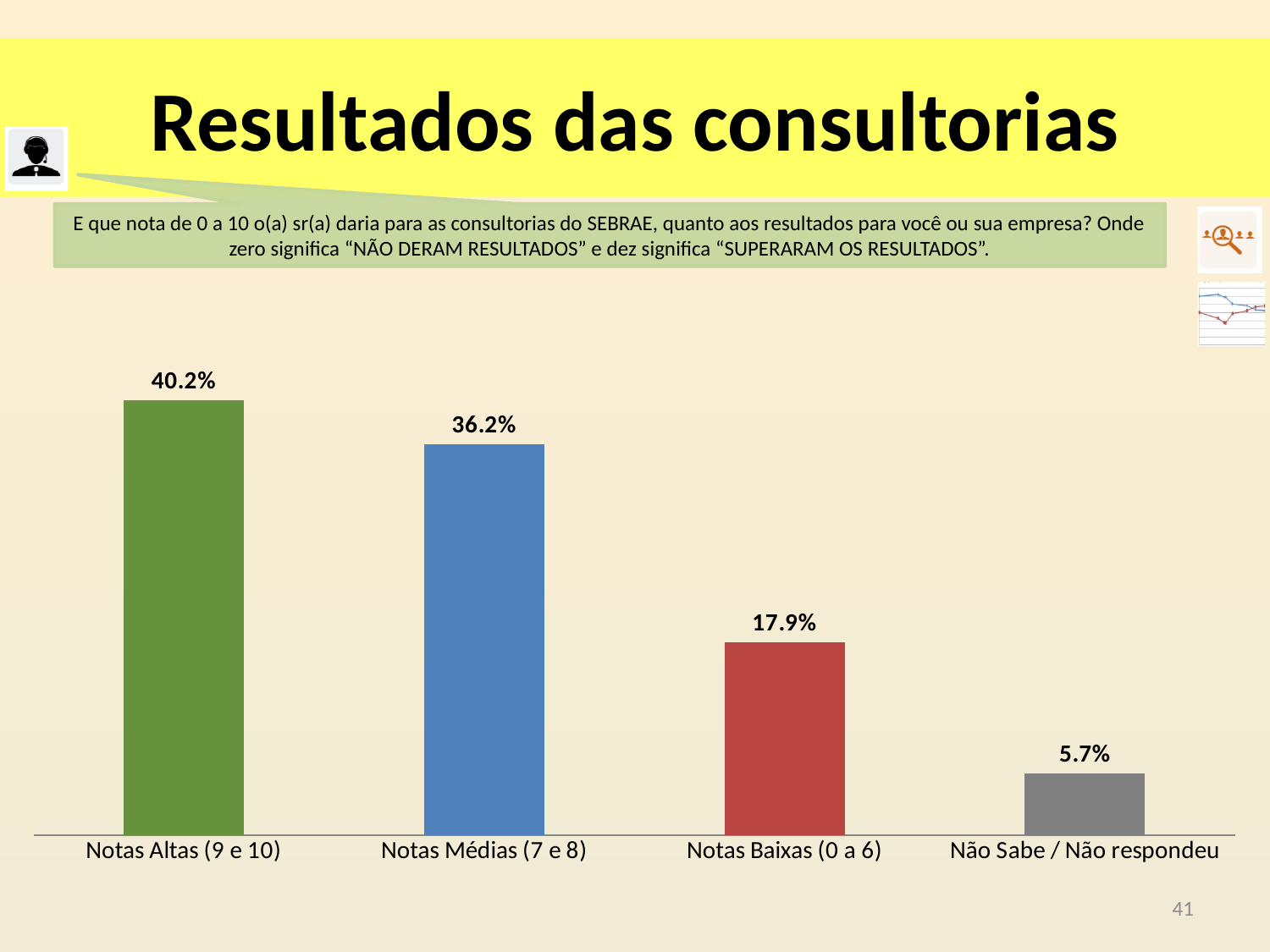
Which category has the highest value? Notas Altas (9 e 10) What is the value for Notas Baixas (0 a 6)? 17.9% What is the value for Não Sabe / Não respondeu? 5.7% Which is larger, the value for Notas Médias (7 e 8) or the value for Notas Baixas (0 a 6)? Notas Médias (7 e 8) What kind of chart is shown on the slide? Bar chart Which category has the lowest value? Não Sabe / Não respondeu What is the value for Notas Médias (7 e 8)? 36.2% How many categories are shown in the chart? 4 Do the values rise or fall from left to right across the categories? Fall What is the difference between the values for Notas Altas (9 e 10) and Notas Médias (7 e 8)? 4.0% What is the value for Notas Altas (9 e 10)? 40.2% What is the difference between the values for Notas Baixas (0 a 6) and Não Sabe / Não respondeu? 12.2%